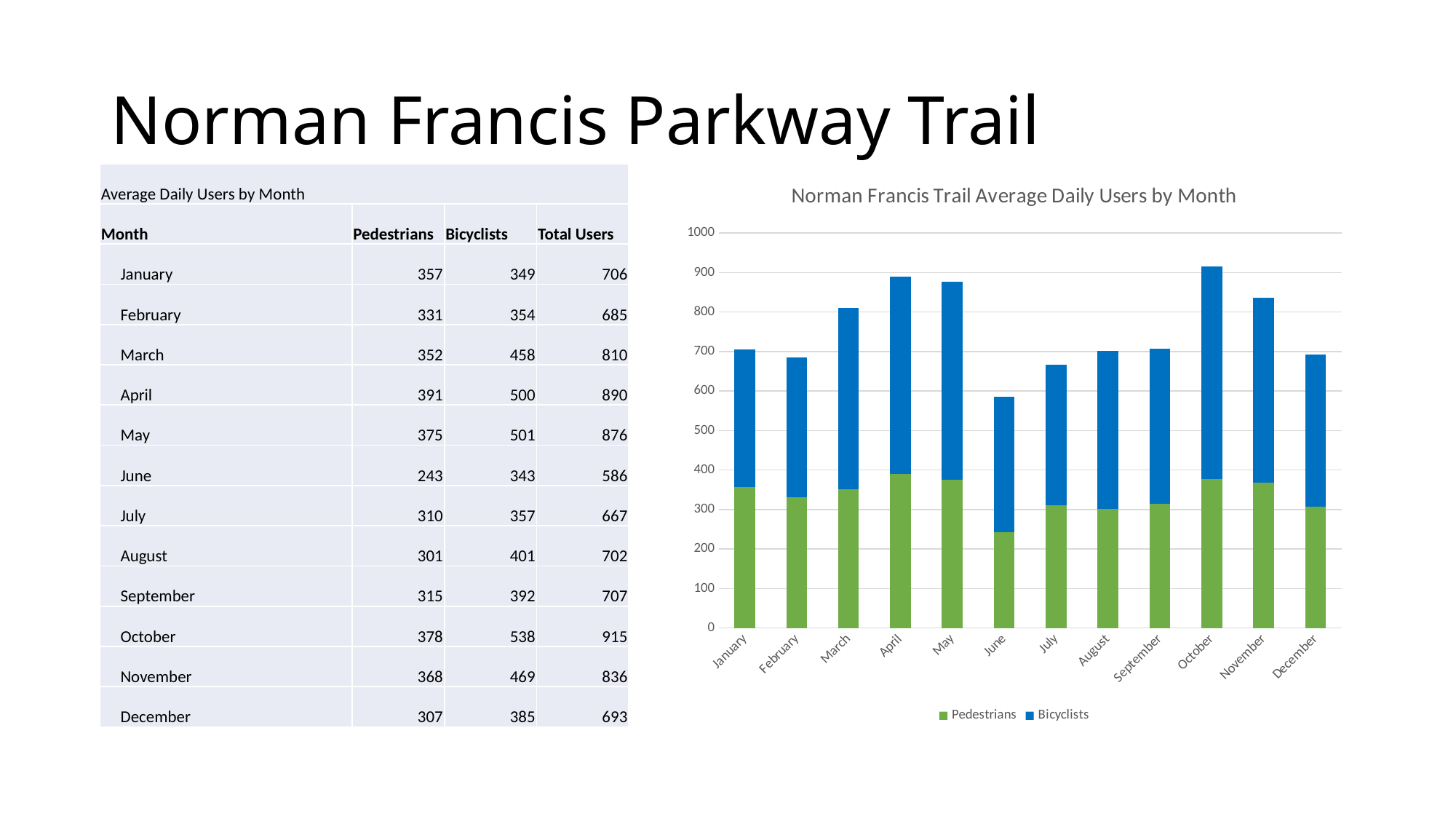
How many series does the chart legend list? 2 Which month has the lowest total bar in the chart? June Which series is shown in green in the chart? Pedestrians What type of chart is shown on the slide? stacked bar chart Which month has the highest total bar in the chart? October How many months are plotted along the x axis of the chart? 12 What is the title of the chart? Norman Francis Trail Average Daily Users by Month Is the total users value for October greater or less than 900? greater According to the slide, what is the total number of average daily users in April? 890 Is the total bar for April taller or shorter than the total bar for May? taller Is the total users value for June greater or less than 600? less According to the slide, what is the average daily number of bicyclists in October? 538